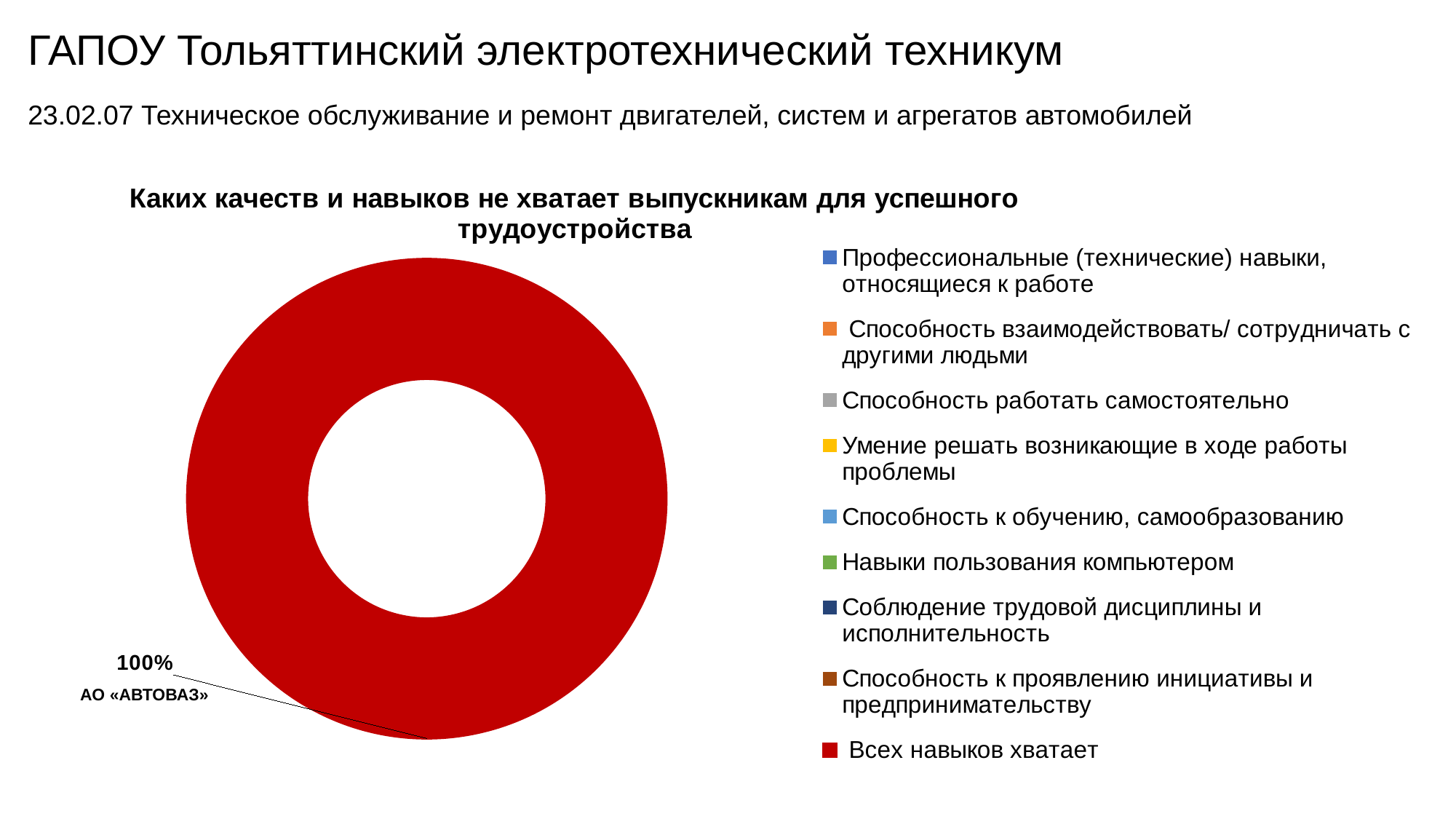
Is the value for 'Всех навыков хватает' greater or less than 50%? greater What is the title of the chart? Каких качеств и навыков не хватает выпускникам для успешного трудоустройства What kind of chart is shown on the slide? Doughnut (pie) chart Which employer is named next to the 100% data label on the chart? АО «АВТОВАЗ» Which legend category does the single visible slice of the chart correspond to? Всех навыков хватает What is the value shown by the data label on the chart? 100% How many slices are visible in the doughnut chart? 1 What share of the chart does the slice labelled 100% represent? 100% How many categories does the chart's legend list? 9 What colour is the slice that fills the entire doughnut chart? Red